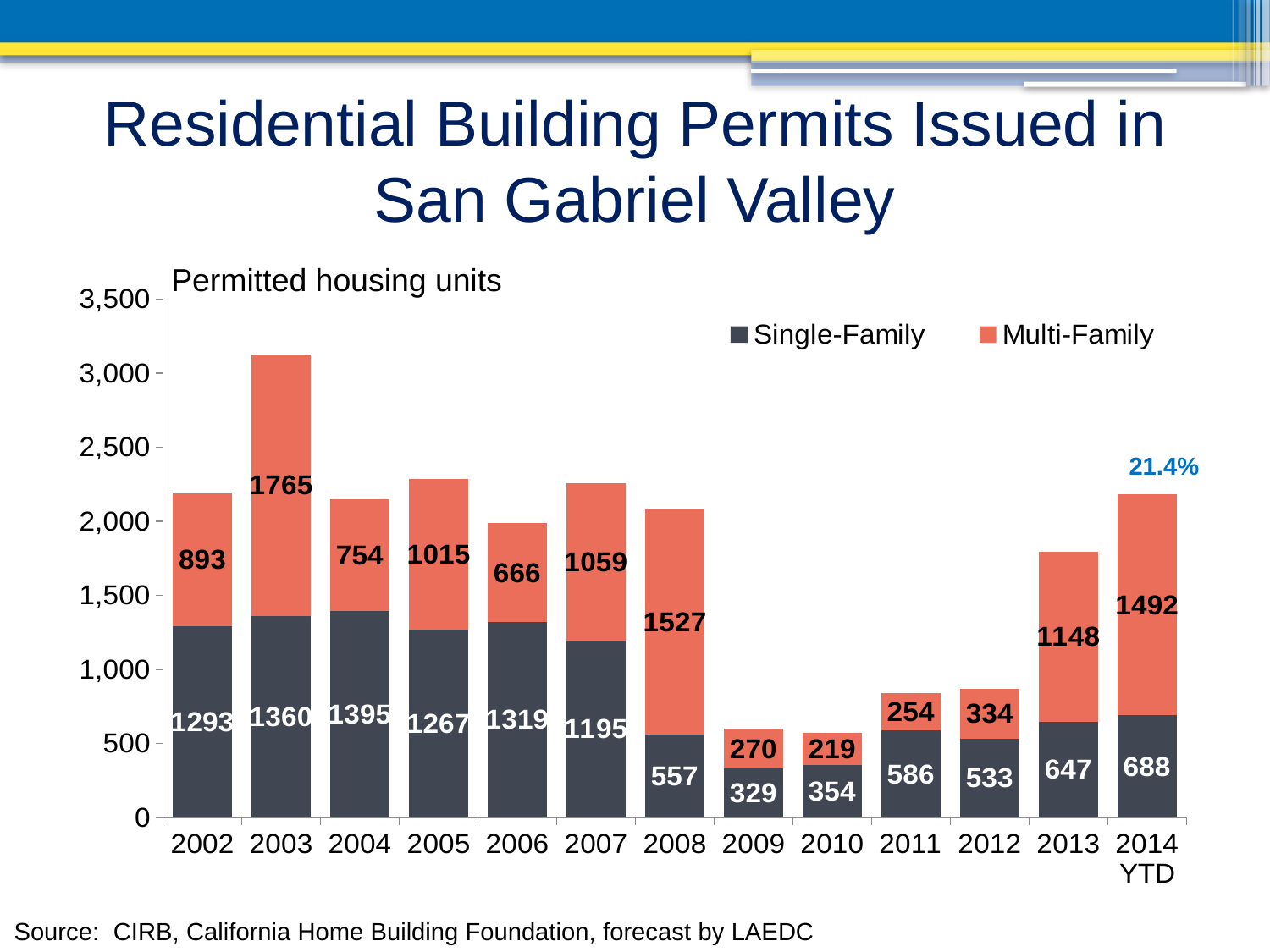
What is the Multi-Family value for 2008? 1527 What kind of chart is shown on the slide? Stacked bar chart What percentage is printed above the 2014 YTD bar? 21.4% Which is larger, the Single-Family value for 2011 or for 2012? 2011 What is the total of the stacked bar for 2003? 3125 What is the total of the stacked bar for 2014 YTD? 2180 How many Single-Family permitted housing units were issued in 2004? 1395 Which year has the highest Multi-Family value? 2003 What is the difference between the Multi-Family values for 2014 YTD and 2013? 344 How many years are shown on the x axis? 13 Which year has the lowest Single-Family value? 2009 How many series does the legend list? 2